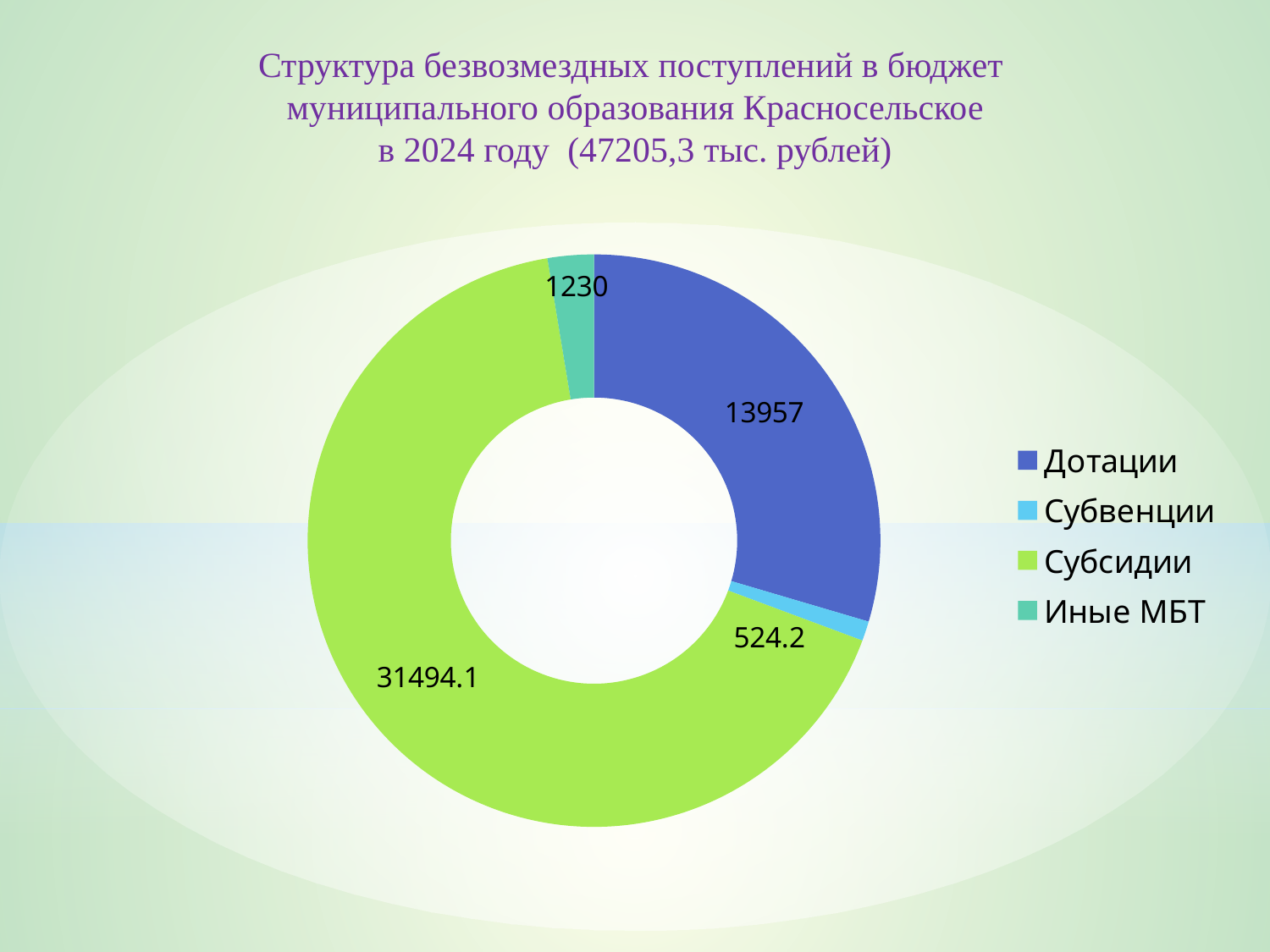
Which category has the largest value? Субсидии What colour is the Субсидии slice? green What is the value for Субсидии? 31494.1 What is the value for Иные МБТ? 1230 How many categories does the chart show? 4 What is the difference between the values for Субсидии and Дотации? 17537.1 Which category has the smallest value? Субвенции Which is larger, the value for Дотации or the value for Иные МБТ? Дотации What is the value for Субвенции? 524.2 What is the difference between the values for Иные МБТ and Субвенции? 705.8 What is the value for Дотации? 13957 What kind of chart is shown on the slide? doughnut chart